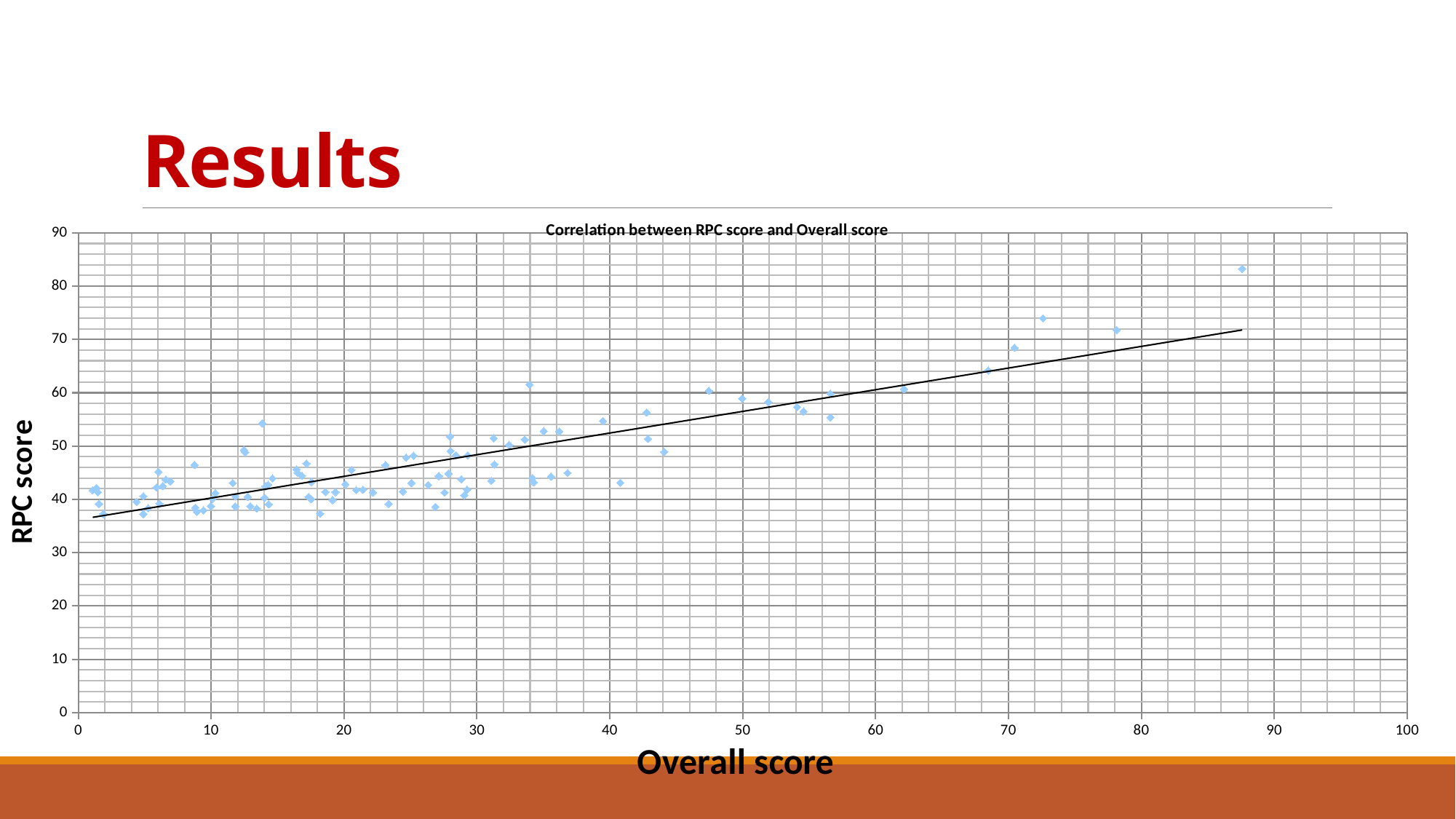
What is the highest value shown on the x axis? 100 As Overall score increases along the x axis, does RPC score generally rise or fall? Rise Is the RPC score of the point with the highest Overall score greater or less than 80? greater What is the label of the vertical axis? RPC score Are there any points with an RPC score below 30? No Is the RPC score of the point with the lowest Overall score greater or less than 50? less What kind of chart is shown on the slide? Scatter chart Does the fitted line in the chart slope upward or downward? Upward Which point has the higher RPC score: the one with the highest Overall score or the one at Overall score 72? The one with the highest Overall score What is the title of the chart? Correlation between RPC score and Overall score